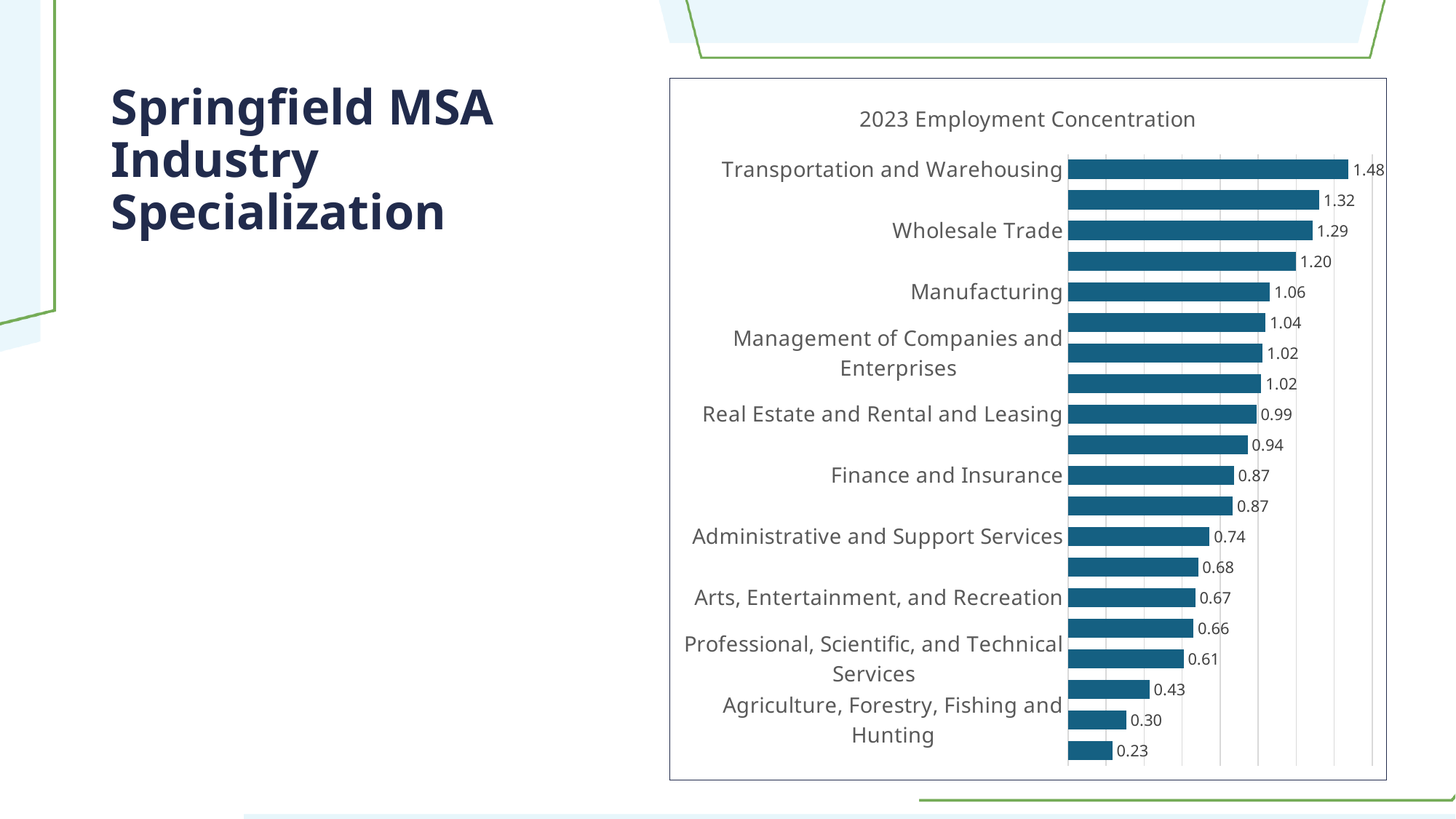
Which industry has the highest employment concentration? Transportation and Warehousing What is the lowest value shown on the chart? 0.23 What is the value for Agriculture, Forestry, Fishing and Hunting? 0.30 What is the value for Wholesale Trade? 1.29 Which is larger, the value for Wholesale Trade or the value for Manufacturing? Wholesale Trade What is the value for Real Estate and Rental and Leasing? 0.99 What is the title of the chart? 2023 Employment Concentration What is the value for Manufacturing? 1.06 What is the value for Transportation and Warehousing? 1.48 What is the value for Administrative and Support Services? 0.74 What kind of chart is shown on the slide? bar chart What is the difference between the values for Transportation and Warehousing and Wholesale Trade? 0.19